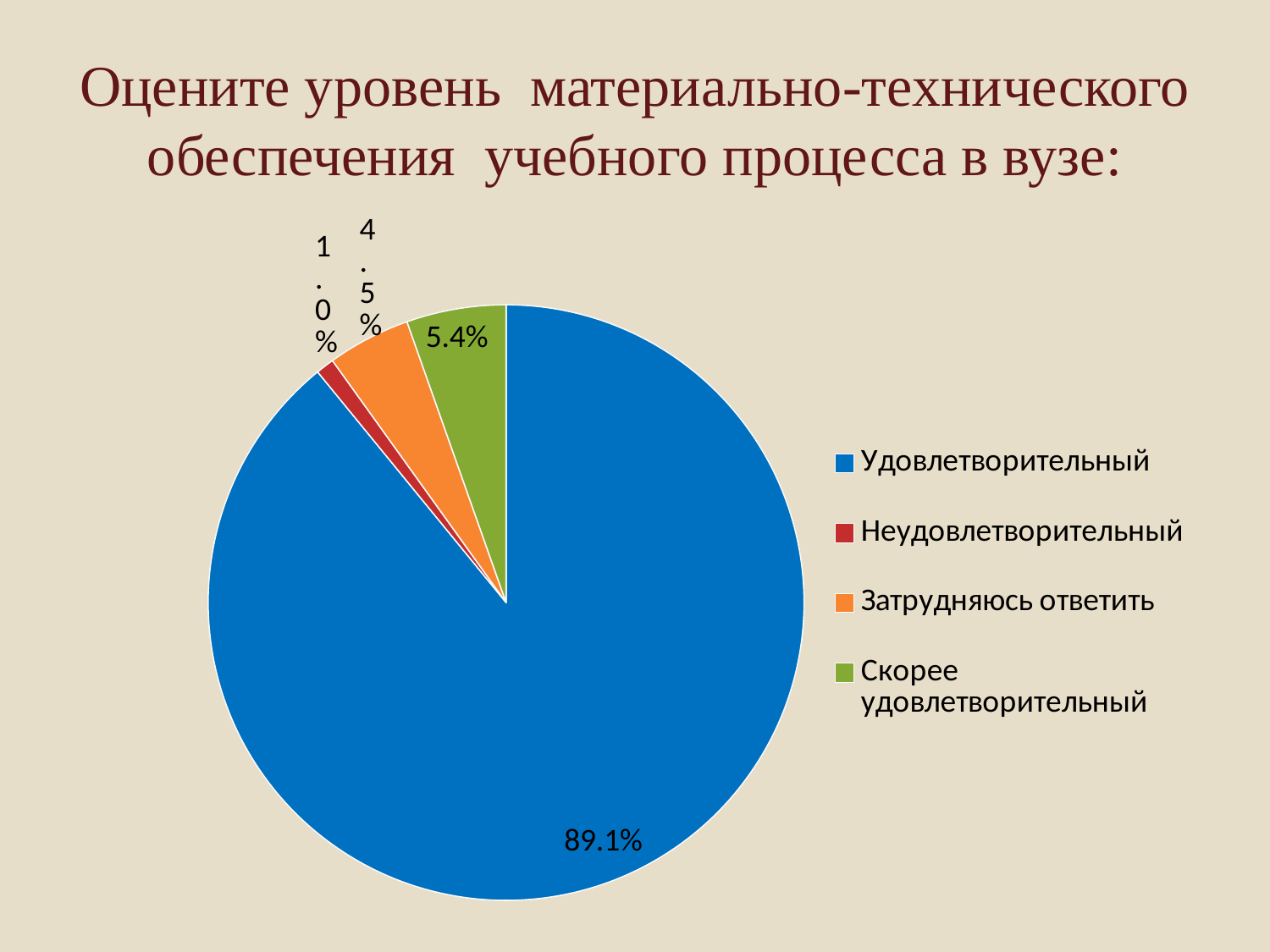
What is the difference between the shares for "Удовлетворительный" and "Скорее удовлетворительный"? 83.7% How many categories does the pie chart show? 4 What is the difference between the shares for "Затрудняюсь ответить" and "Неудовлетворительный"? 3.5% Which category has the smallest slice of the pie? Неудовлетворительный What share of respondents answered "Скорее удовлетворительный"? 5.4% What share of respondents answered "Затрудняюсь ответить"? 4.5% Which category has the largest slice of the pie? Удовлетворительный What colour is the slice for "Затрудняюсь ответить"? orange What kind of chart is shown on the slide? pie chart What share of respondents answered "Неудовлетворительный"? 1.0% What share of respondents answered "Удовлетворительный"? 89.1% Which is larger: the share for "Скорее удовлетворительный" or the share for "Затрудняюсь ответить"? Скорее удовлетворительный